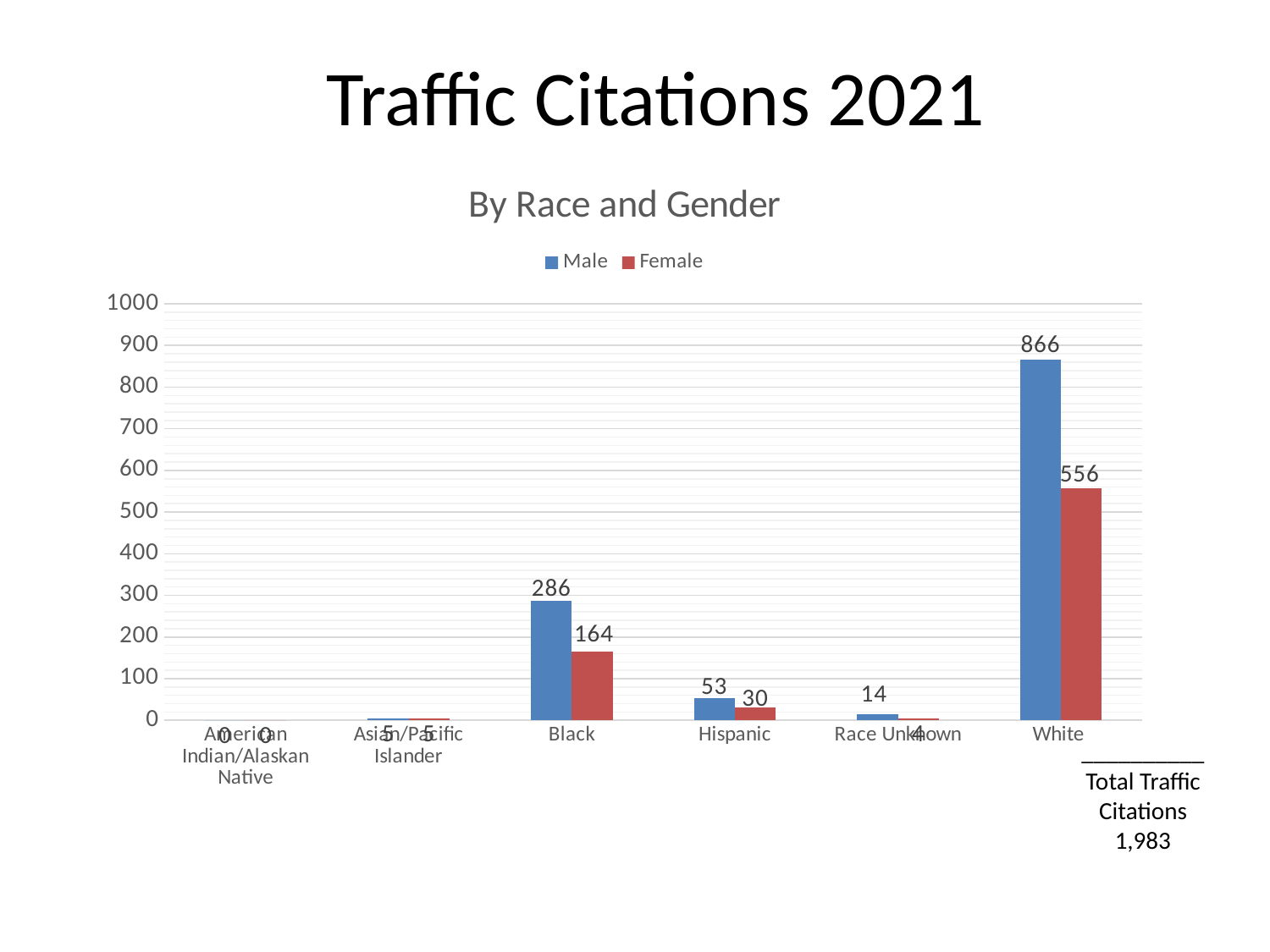
How many race categories are shown on the x axis? 6 What is the Female value for White? 556 Which category has the highest Male value? White What is the difference between the Male and Female values for Black? 122 What is the difference between the Male and Female values for White? 310 What kind of chart is shown on the slide? Bar chart Which is larger, the Male value for Hispanic or the Female value for Hispanic? Male What is the Male value for White? 866 What total number of traffic citations is stated on the slide? 1,983 What is the Male value for Hispanic? 53 What is the Female value for Black? 164 How many series does the legend list? 2